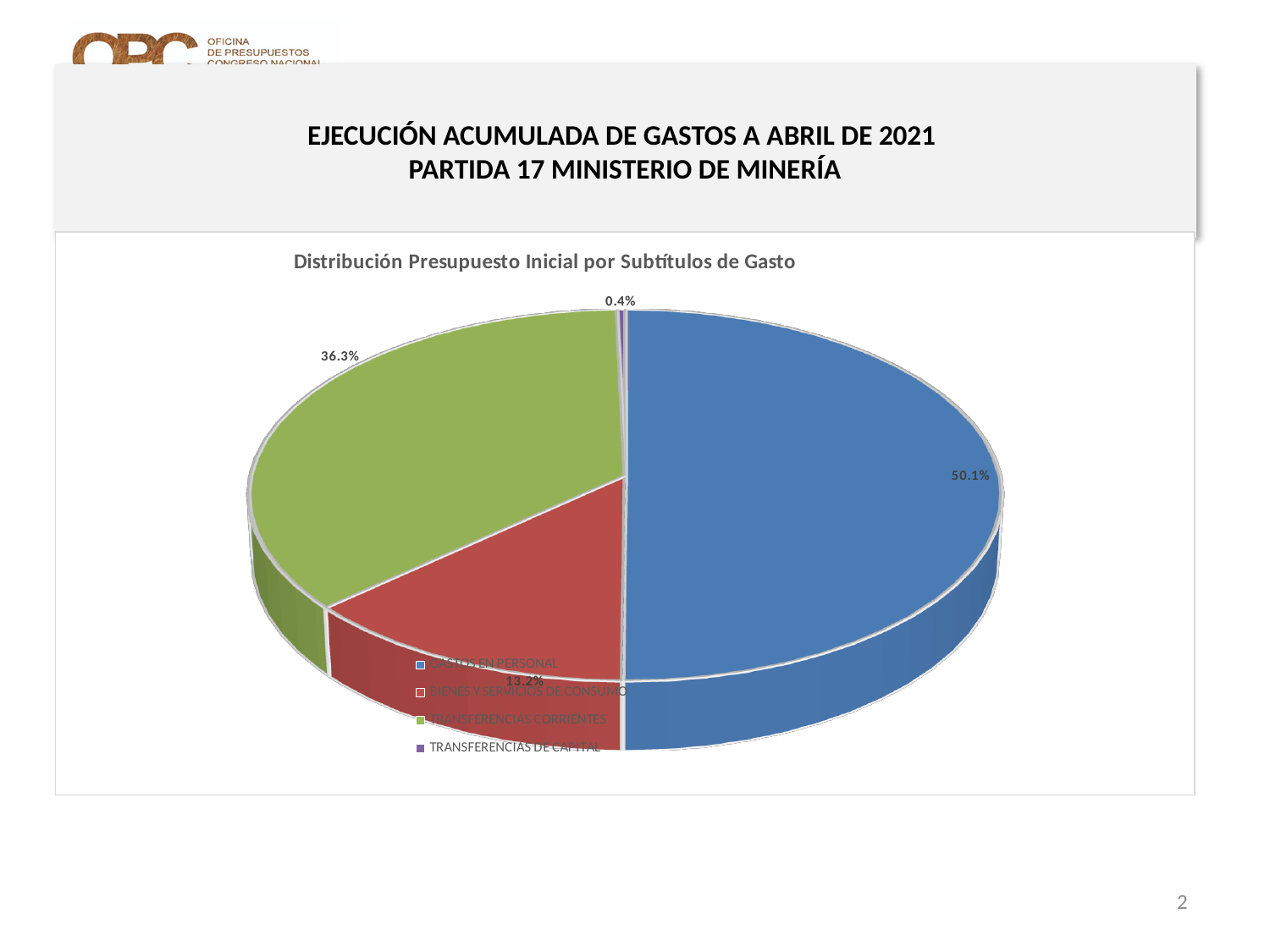
What share of the pie does TRANSFERENCIAS DE CAPITAL represent? 0.4% What share of the pie does TRANSFERENCIAS CORRIENTES represent? 36.3% What kind of chart is shown on the slide? Pie chart What colour is the slice for GASTOS EN PERSONAL? Blue What is the difference in percentage points between the GASTOS EN PERSONAL share and the TRANSFERENCIAS CORRIENTES share? 13.8 percentage points Which category has the largest slice of the pie? GASTOS EN PERSONAL Which category has the smallest slice of the pie? TRANSFERENCIAS DE CAPITAL What share of the pie does GASTOS EN PERSONAL represent? 50.1% What is the chart's title? Distribución Presupuesto Inicial por Subtítulos de Gasto Which is larger, the share for TRANSFERENCIAS CORRIENTES or the share for BIENES Y SERVICIOS DE CONSUMO? TRANSFERENCIAS CORRIENTES How many categories does the pie chart show? 4